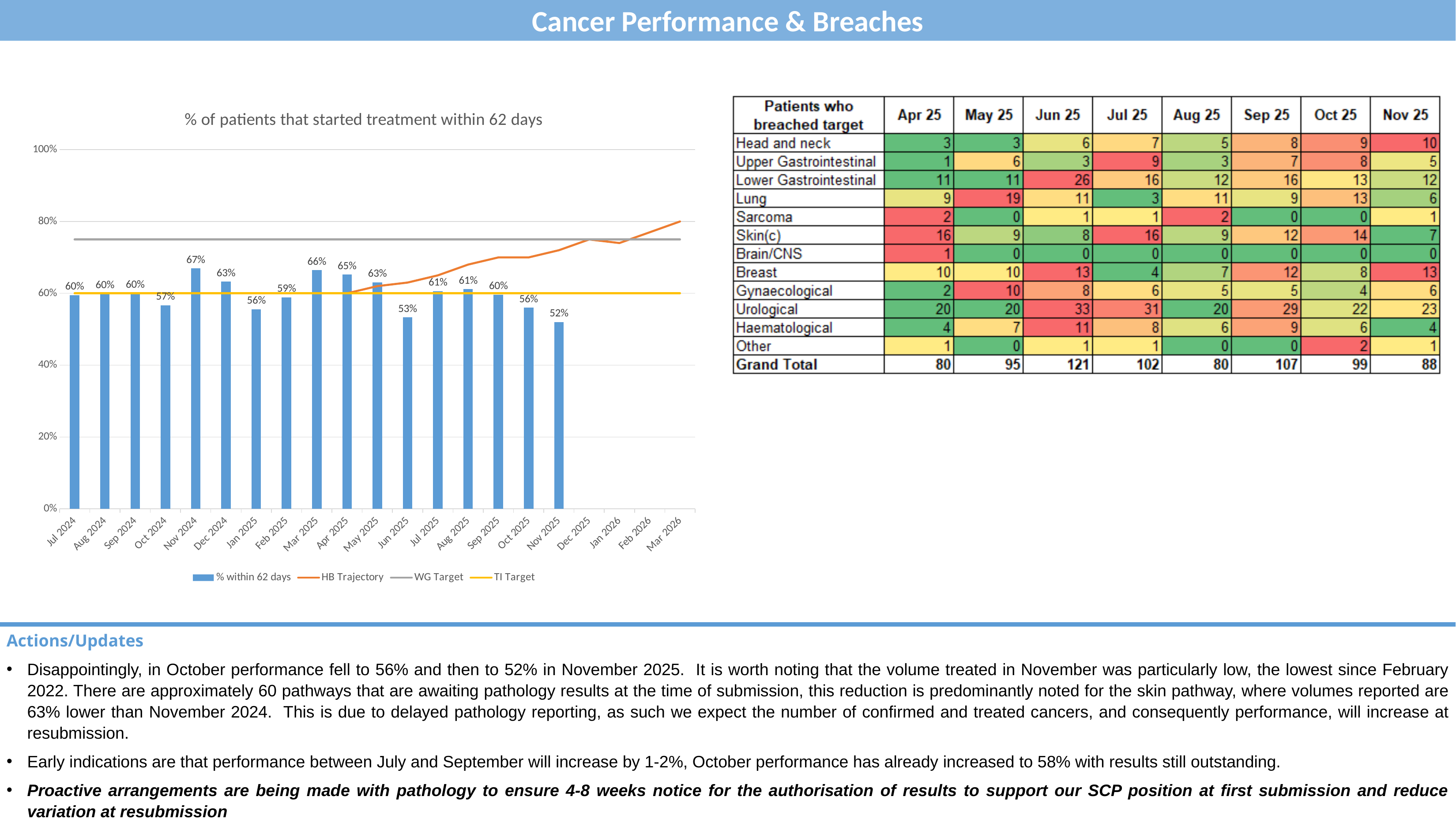
Which month has the highest % within 62 days? Nov 2024 Is the value for Jun 2025 greater or less than 60%? less Which is larger, the value for Apr 2025 or the value for May 2025? Apr 2025 What is the title of the chart? % of patients that started treatment within 62 days How many months have a bar plotted in the chart? 17 What is the value for Jun 2025 in the chart? 53% What is the value for Nov 2025 in the chart? 52% Which month has the lowest % within 62 days? Nov 2025 What is the value for Mar 2025 in the chart? 66% What is the value for Nov 2024 in the chart? 67% What is the difference between the values for Oct 2025 and Nov 2025? 4% How many series does the chart legend list? 4